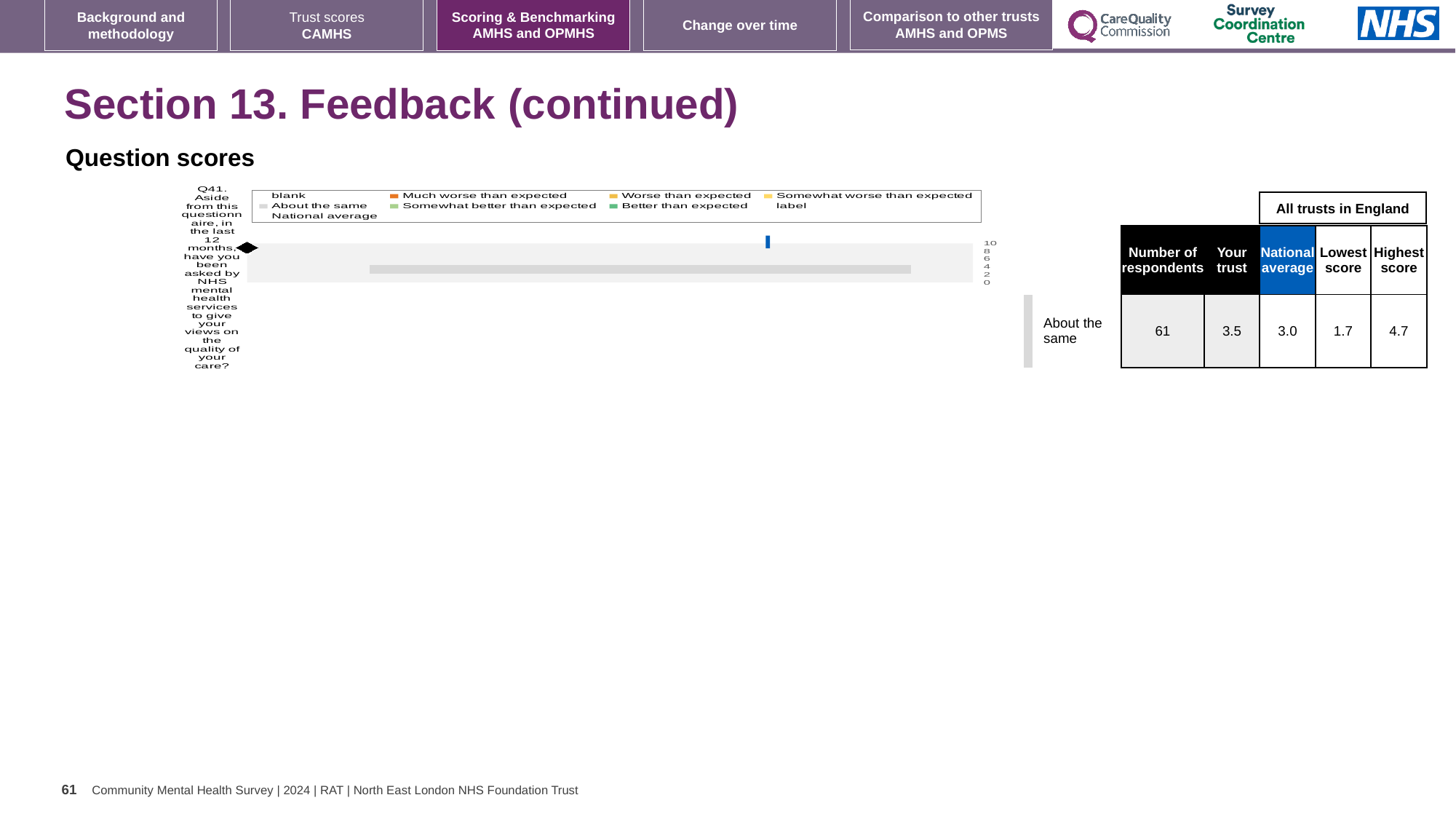
In the table beside the chart, what is the highest score among all trusts in England for Q41? 4.7 In the table beside the chart, what is the 'Your trust' score for Q41? 3.5 Which benchmark category is shown for Q41 next to the chart? About the same For Q41, how much higher is the 'Your trust' score than the national average? 0.5 In the table beside the chart, how many respondents answered Q41? 61 For Q41, what is the difference between the highest score and the lowest score among all trusts in England? 3.0 What kind of chart is shown on the slide for Q41? bar chart In the table beside the chart, what is the national average score for Q41? 3.0 How many survey questions are plotted in the chart? 1 In the table beside the chart, what is the lowest score among all trusts in England for Q41? 1.7 For Q41, which is larger: the 'Your trust' score or the national average? Your trust Which question number is plotted in the chart? Q41